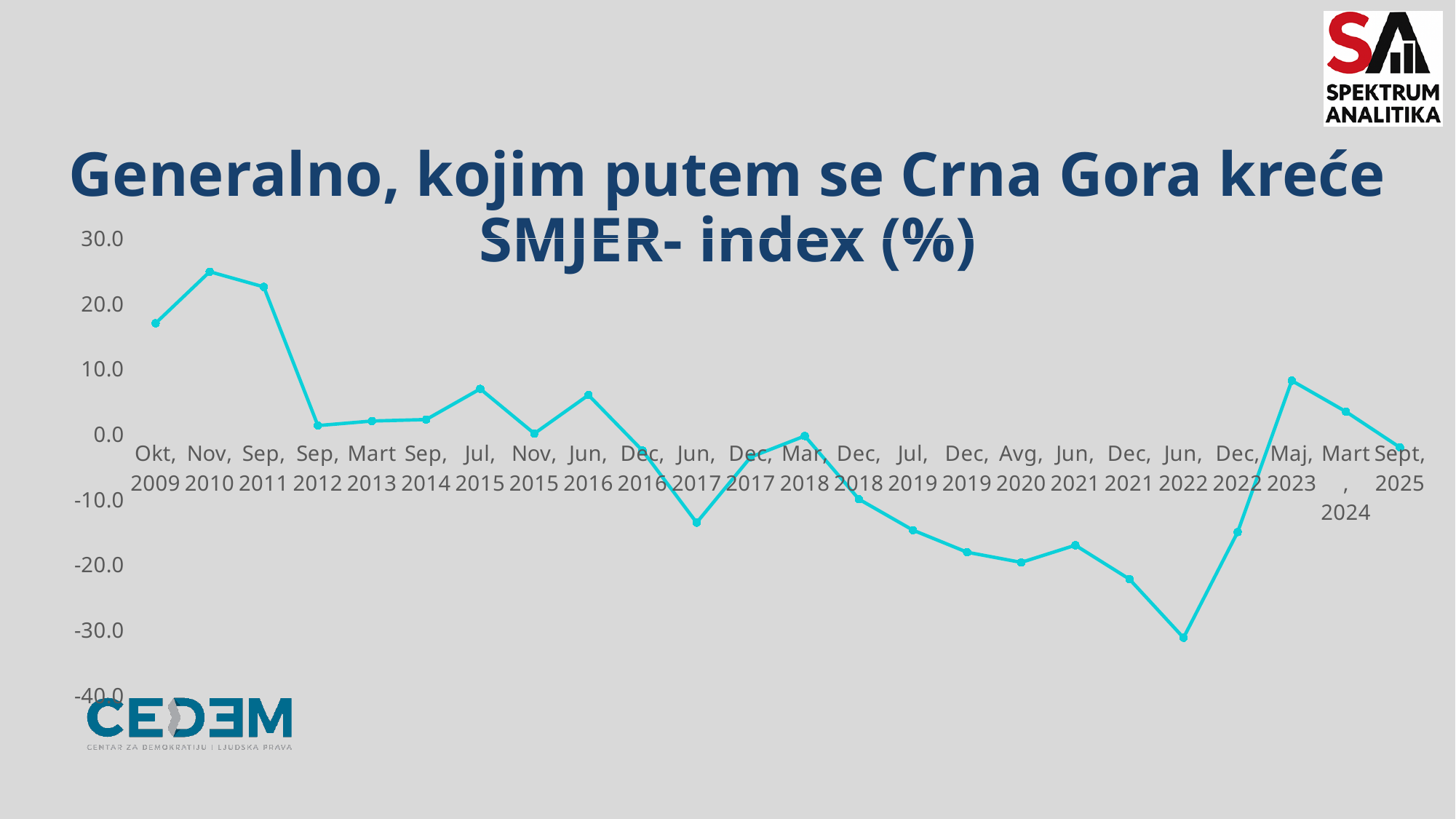
How many data points are plotted on the line? 24 What kind of chart is shown on the slide? line chart Is the value for Maj, 2023 greater or less than 10.0? less Is the value for Jun, 2022 greater or less than -30.0? less Which has the larger value, Okt, 2009 or Sep, 2011? Sep, 2011 What is the title of the chart? Generalno, kojim putem se Crna Gora kreće SMJER- index (%) Which period has the highest value of the SMJER index? Nov, 2010 Is the value for Jun, 2017 greater or less than -10.0? less Does the line rise or fall from Jun, 2022 to Maj, 2023? rise Which period has the lowest value of the SMJER index? Jun, 2022 Which has the larger value, Maj, 2023 or Sept, 2025? Maj, 2023